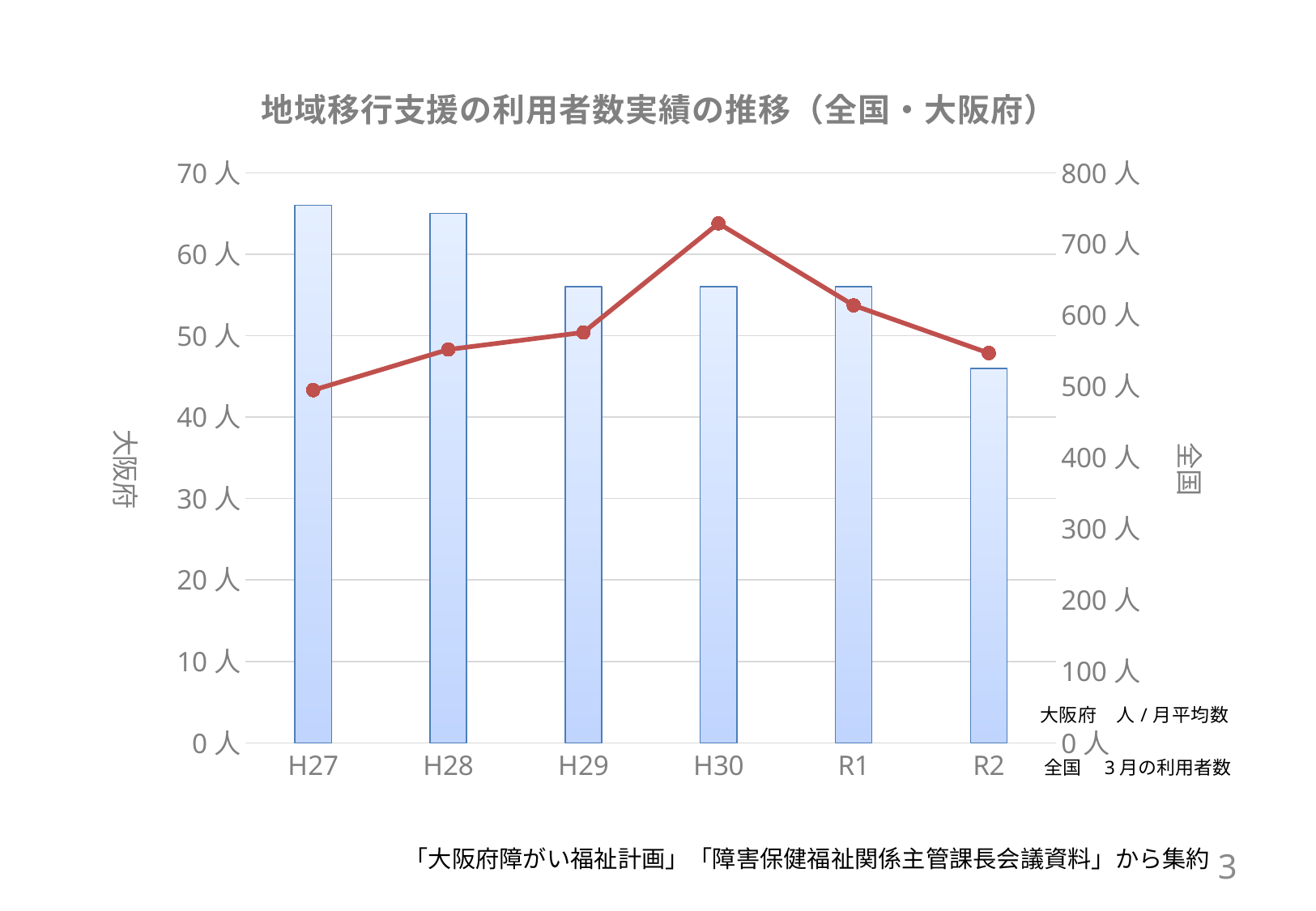
Is the 全国 value for H27 greater or less than 600人? less Does the 全国 line rise or fall from H27 to H30? rise Which is larger, the 大阪府 bar for H29 or for R2? H29 Is the 大阪府 bar for R2 greater or less than 50人? less How many categories are shown on the x axis? 6 Which category has the lowest point on the 全国 line? H27 What is the label on the left vertical axis? 大阪府 Is the 大阪府 bar for H27 greater or less than 60人? greater Which category has the highest value for the 全国 line? H30 What kind of chart is shown on the slide? A combination bar and line chart Which category has the lowest bar for 大阪府? R2